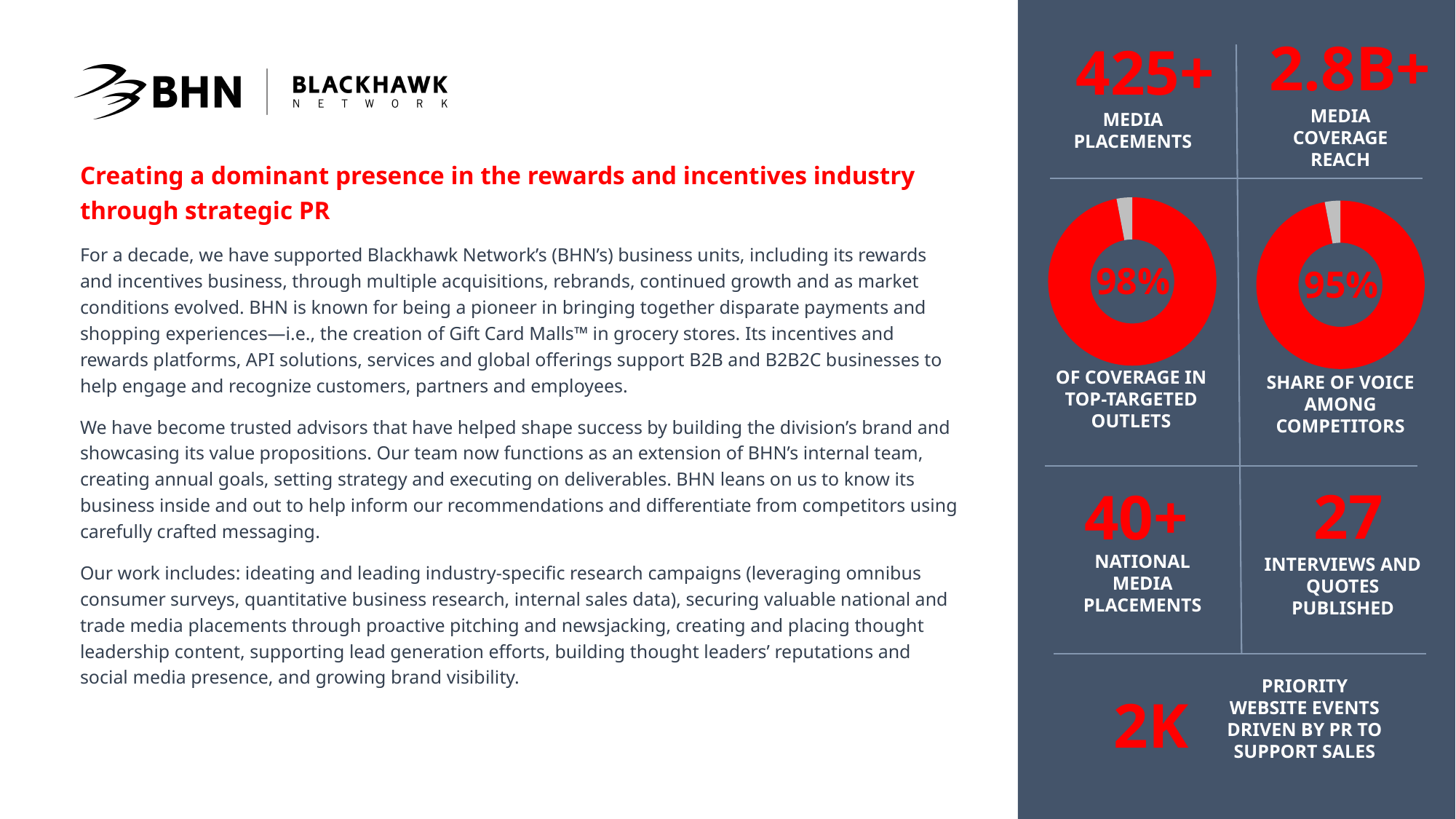
What percentage is shown in the right donut chart labelled 'Share of voice among competitors'? 95% What is the label beneath the donut chart showing 95%? Share of voice among competitors What kind of chart is used to show the 98% coverage in top-targeted outlets? Donut (pie) chart Which donut chart shows the larger percentage, 'Of coverage in top-targeted outlets' or 'Share of voice among competitors'? Of coverage in top-targeted outlets In the 'Share of voice among competitors' donut chart, is the red slice greater or less than 50%? greater What is the difference between the percentage in the 'Of coverage in top-targeted outlets' chart and the 'Share of voice among competitors' chart? 3% What percentage is shown in the left donut chart labelled 'Of coverage in top-targeted outlets'? 98% What colour is the main slice in both donut charts? Red How many donut charts are shown on the slide? 2